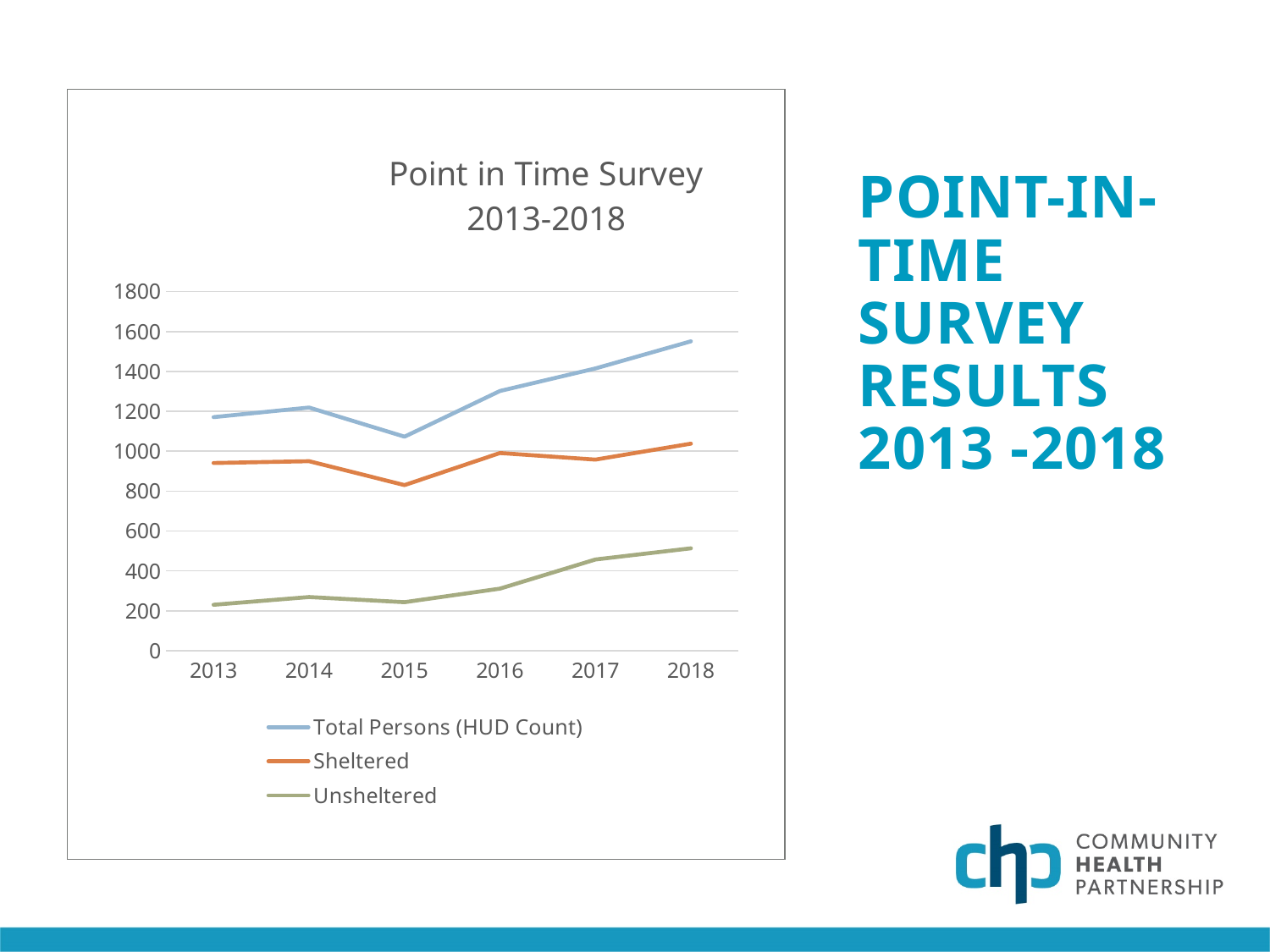
What kind of chart is shown on the slide? Line chart In which year is the Total Persons (HUD Count) value highest? 2018 Which is larger: the Sheltered value for 2018 or the Sheltered value for 2015? 2018 In which year is the Sheltered value lowest? 2015 Is the Sheltered value for 2015 greater or less than 900? less Does the Unsheltered line rise or fall from 2015 to 2018? Rise In which year is the Total Persons (HUD Count) value lowest? 2015 How many years are plotted along the x axis? 6 Is the Total Persons (HUD Count) value for 2018 greater or less than 1400? greater Is the Unsheltered value for 2018 greater or less than 400? greater How many series does the legend list? 3 What is the title of the chart? Point in Time Survey 2013-2018